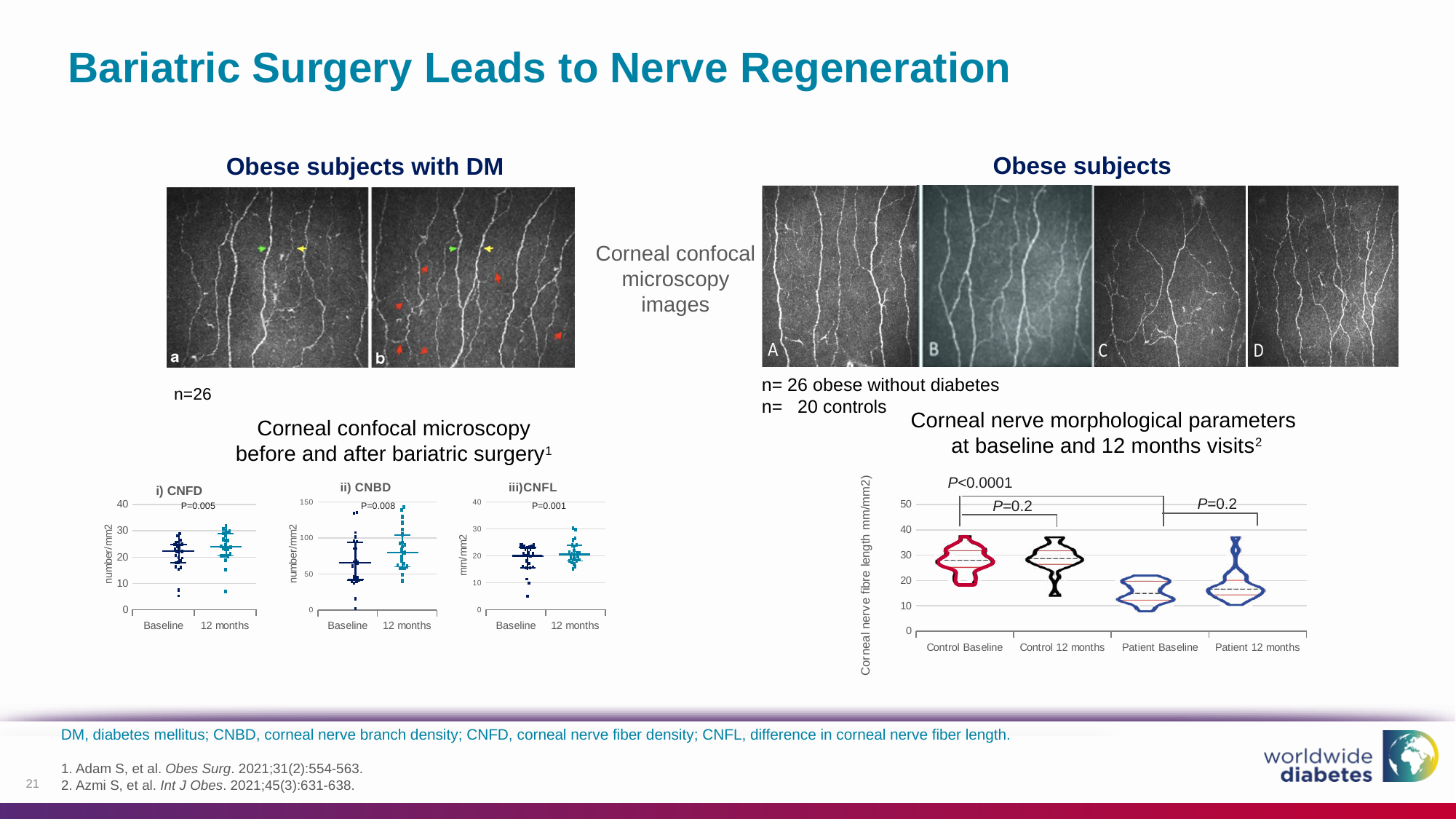
On the 'ii) CNBD' chart, does the mean value rise or fall from Baseline to 12 months? rise On the 'Corneal nerve morphological parameters at baseline and 12 months visits' chart, what is the y-axis label? Corneal nerve fibre length mm/mm2 On the 'Corneal nerve morphological parameters at baseline and 12 months visits' chart, how many categories are shown on the x axis? 4 On the 'Corneal nerve morphological parameters at baseline and 12 months visits' chart, what P value is shown between Patient Baseline and Patient 12 months? P=0.2 On the 'Corneal nerve morphological parameters at baseline and 12 months visits' chart, what P value is shown between Control Baseline and Patient Baseline? P<0.0001 On the 'ii) CNBD' chart, what P value is shown? P=0.008 On the 'ii) CNBD' chart, how many categories are shown on the x axis? 2 On the 'i) CNFD' chart, what P value is shown? P=0.005 On the 'iii)CNFL' chart, what P value is shown? P=0.001 On the 'Corneal nerve morphological parameters at baseline and 12 months visits' chart, which has the higher corneal nerve fibre length: Control Baseline or Patient Baseline? Control Baseline On the 'Corneal nerve morphological parameters at baseline and 12 months visits' chart, is the median value for Patient Baseline greater or less than 20? less On the 'Corneal nerve morphological parameters at baseline and 12 months visits' chart, what kind of chart is it? Violin plot